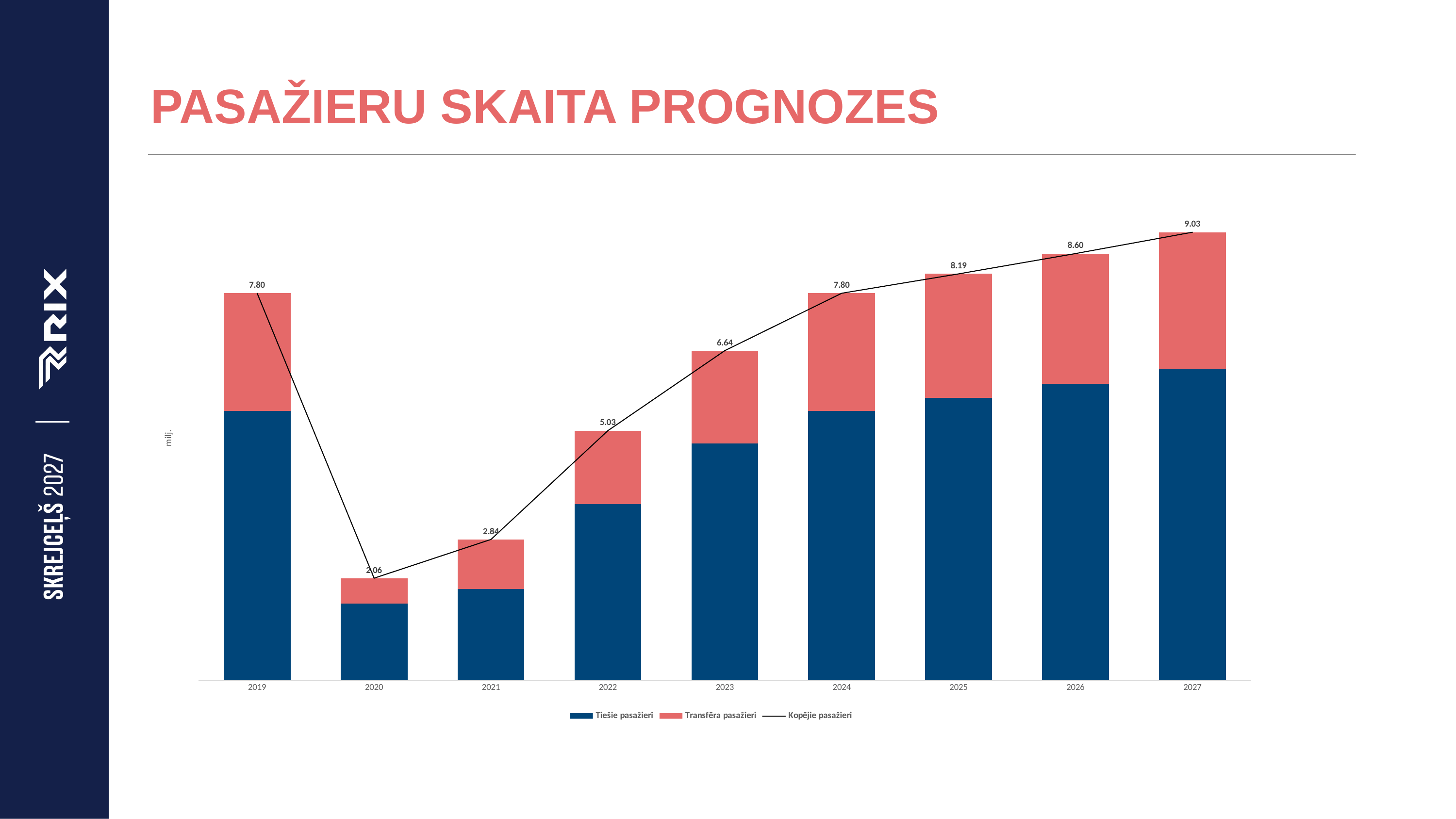
How many years are shown on the x axis? 9 What is the value of Kopējie pasažieri for 2020? 2.06 Which is larger, the Kopējie pasažieri value for 2025 or for 2024? 2025 Which year has the highest value of Kopējie pasažieri? 2027 How many series does the legend list? 3 What is the title of the slide? PASAŽIERU SKAITA PROGNOZES What is the difference between the Kopējie pasažieri values for 2027 and 2019? 1.23 What is the difference between the Kopējie pasažieri values for 2022 and 2021? 2.19 Do the Kopējie pasažieri values rise or fall from 2020 to 2027? rise Which year has the lowest value of Kopējie pasažieri? 2020 What is the value of Kopējie pasažieri for 2023? 6.64 What is the value of Kopējie pasažieri for 2027? 9.03